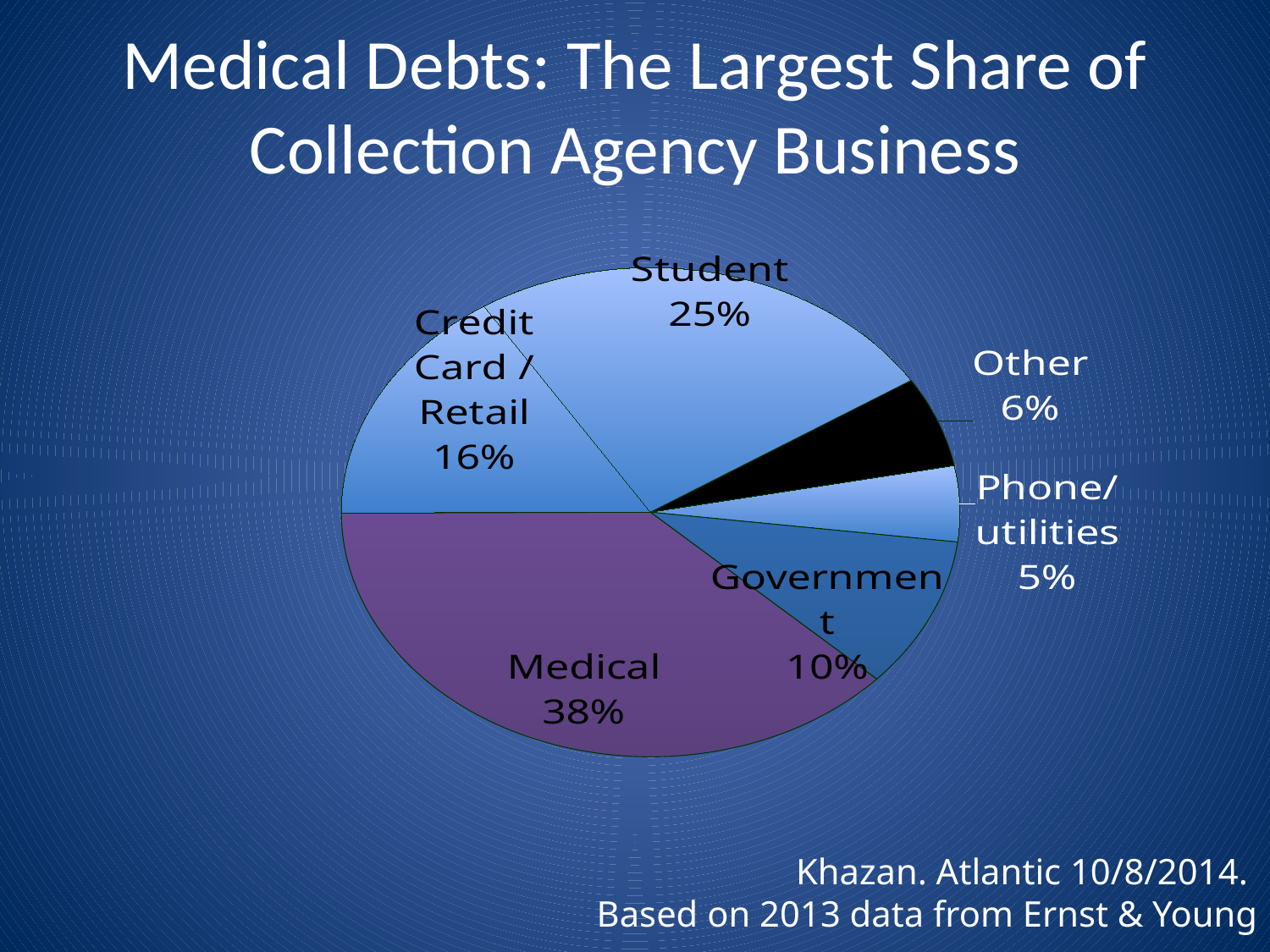
Which category has the largest share of the pie? Medical Which is larger, the Government share or the Other share? Government What is the difference in percentage points between Medical and Student? 13 What is the title of the slide containing the chart? Medical Debts: The Largest Share of Collection Agency Business How many slices does the pie chart have? 6 What percentage does the Student slice represent? 25% What is the value shown for Credit Card / Retail? 16% What share of collection agency business is Medical debt? 38% What type of chart is shown on the slide? Pie chart What is the combined share of Other and Phone/utilities? 11% Which category has the smallest share of the pie? Phone/utilities What percentage is shown for Phone/utilities? 5%